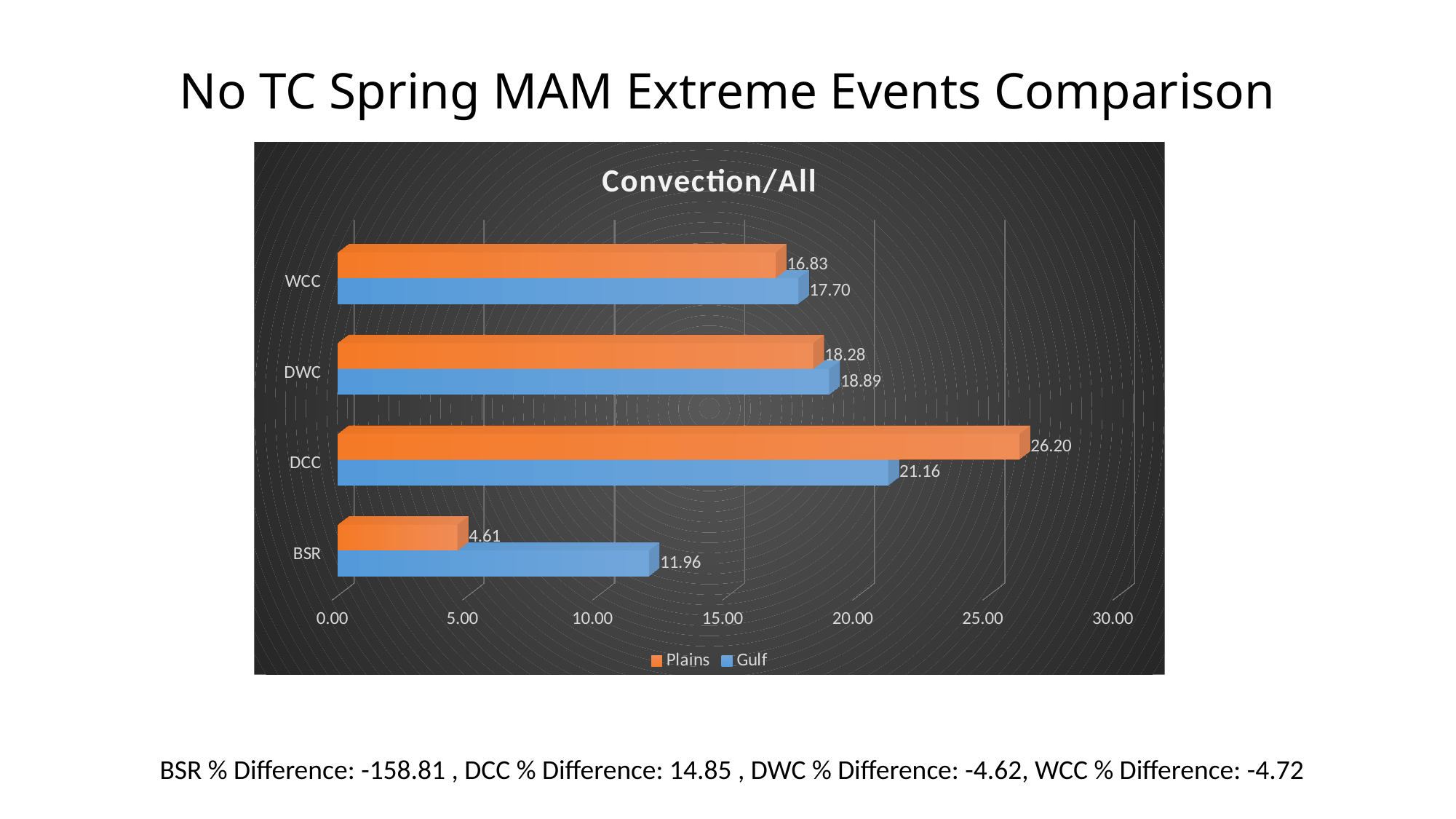
Which is larger for DCC, the Plains value or the Gulf value? Plains What is the Plains value for DCC? 26.20 What is the Gulf value for BSR? 11.96 What is the Plains value for DWC? 18.28 How many categories are shown on the chart? 4 What type of chart is shown? bar chart Is the Plains value for BSR greater or less than 5.00? less How many series does the legend list? 2 Which category has the lowest Gulf value? BSR Which category has the highest Plains value? DCC What is the Gulf value for WCC? 17.70 What is the difference between the Gulf and Plains values for BSR? 7.35